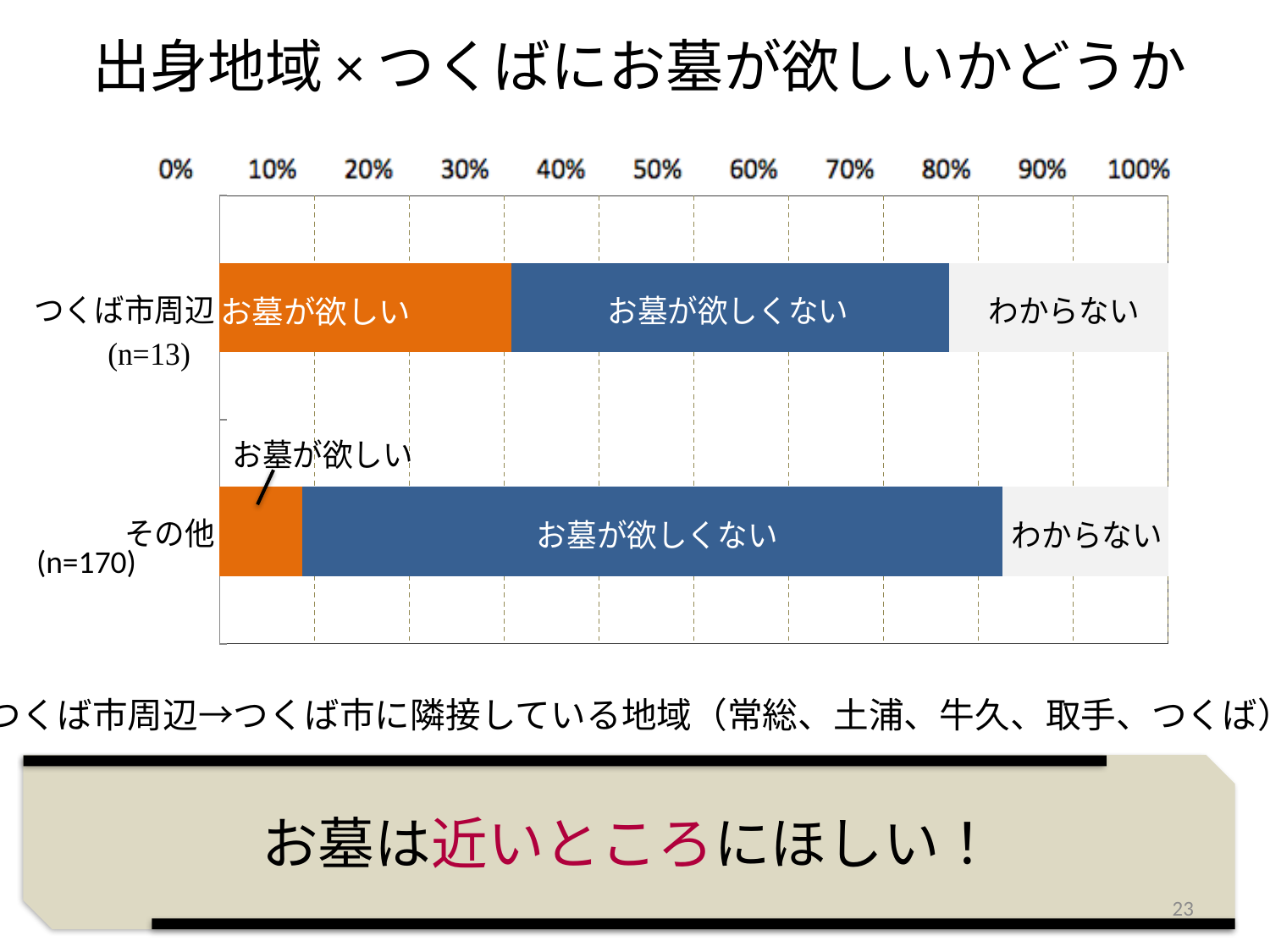
Is the お墓が欲しい share for つくば市周辺 greater or less than 20%? greater Is the お墓が欲しい share for その他 greater or less than 20%? less What is the sample size (n) shown for つくば市周辺? n=13 How many segments (response types) make up each bar? 3 What colour is used for the お墓が欲しい segment? orange What is the title of the chart? 出身地域×つくばにお墓が欲しいかどうか Is the お墓が欲しい share for つくば市周辺 greater or less than 40%? less What is the sample size (n) shown for その他? n=170 Which category has the larger お墓が欲しくない share, つくば市周辺 or その他? その他 How many categories (bars) does the chart show? 2 Which category has the larger お墓が欲しい share, つくば市周辺 or その他? つくば市周辺 What kind of chart is shown on the slide? stacked bar chart